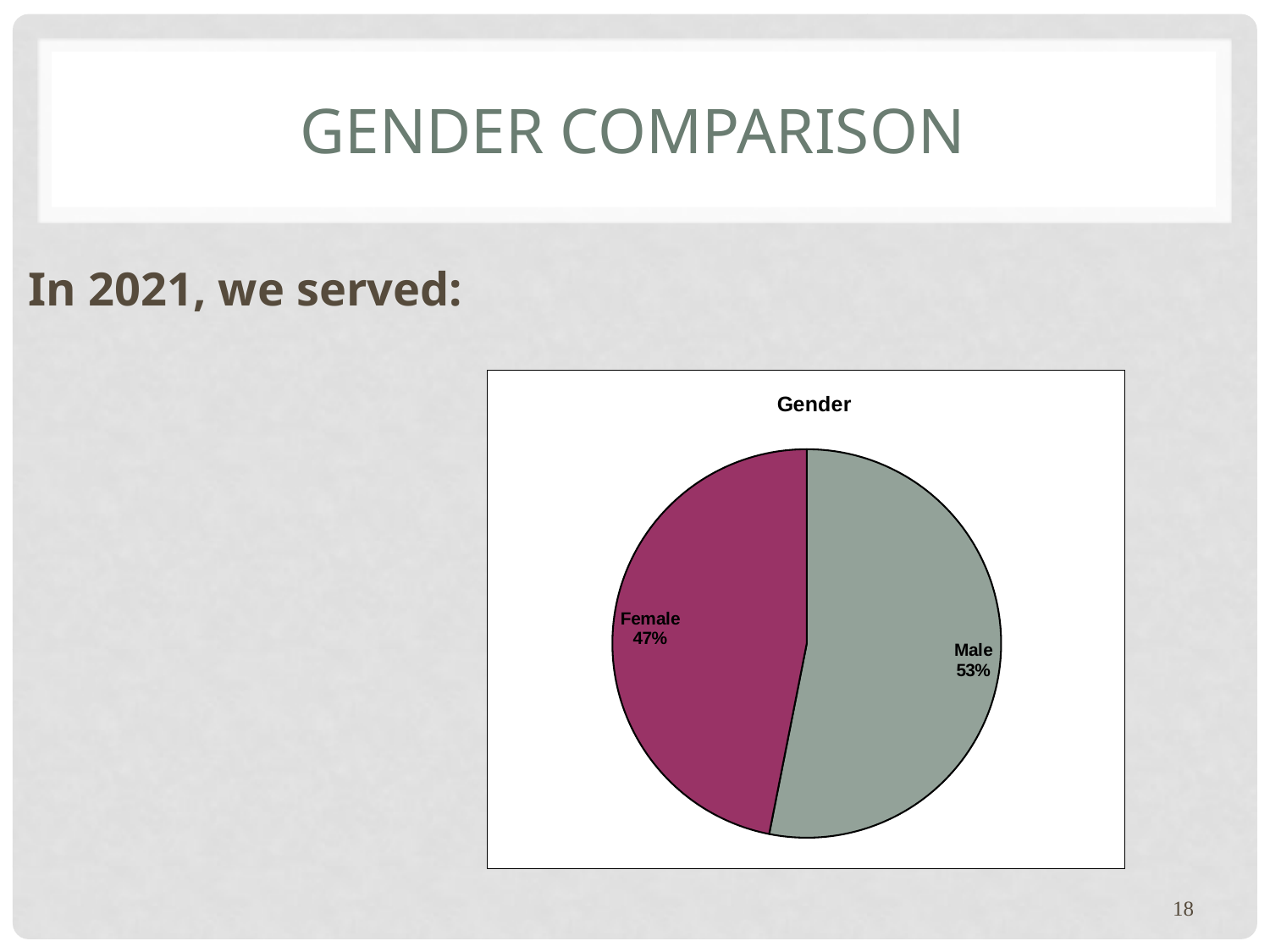
Which slice is the largest in the pie chart? Male What percentage of the pie is Female? 47% What share of the pie does the Male slice represent? 53% Which is larger, the Male slice or the Female slice? Male What type of chart is shown on the slide? pie chart Which slice is the smallest in the pie chart? Female What is the title of the chart? Gender What colour is the Female slice? magenta/purple What is the difference in percentage points between the Male and Female slices? 6 What percentage of the pie is Male? 53% How many slices does the pie chart have? 2